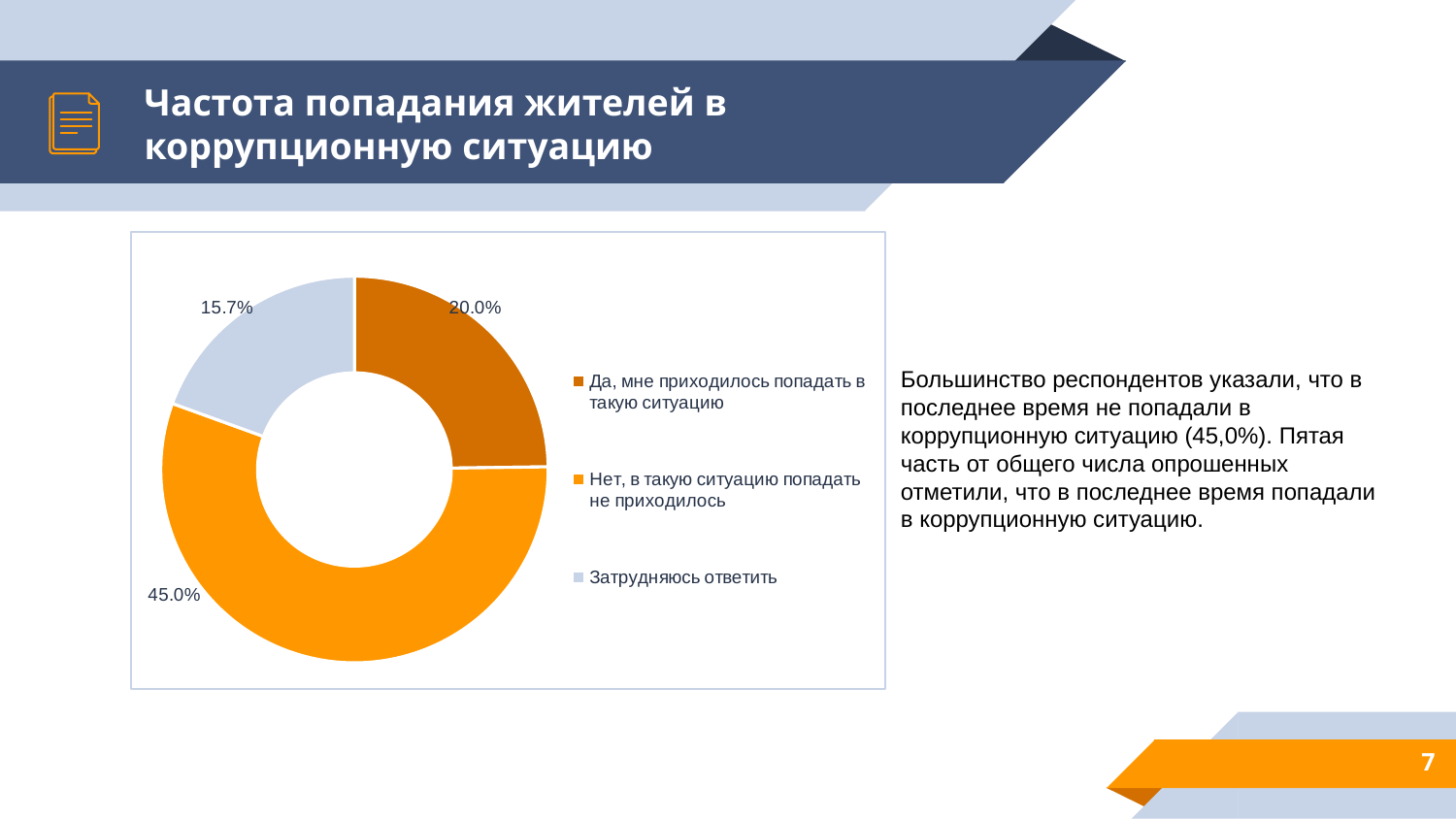
What colour is the slice for "Затрудняюсь ответить"? Light grey-blue What is the value for "Затрудняюсь ответить"? 15.7% How many categories does the chart show? 3 What is the value for "Нет, в такую ситуацию попадать не приходилось"? 45.0% Which is larger: the value for "Да, мне приходилось попадать в такую ситуацию" or for "Затрудняюсь ответить"? Да, мне приходилось попадать в такую ситуацию Which category has the smallest slice? Затрудняюсь ответить What is the title of the slide containing the chart? Частота попадания жителей в коррупционную ситуацию Which category has the largest slice? Нет, в такую ситуацию попадать не приходилось What is the difference between the values for "Да, мне приходилось попадать в такую ситуацию" and "Затрудняюсь ответить"? 4.3% What kind of chart is shown on the slide? Doughnut (pie) chart What is the value for "Да, мне приходилось попадать в такую ситуацию"? 20.0% What is the difference between the values for "Нет, в такую ситуацию попадать не приходилось" and "Да, мне приходилось попадать в такую ситуацию"? 25.0%